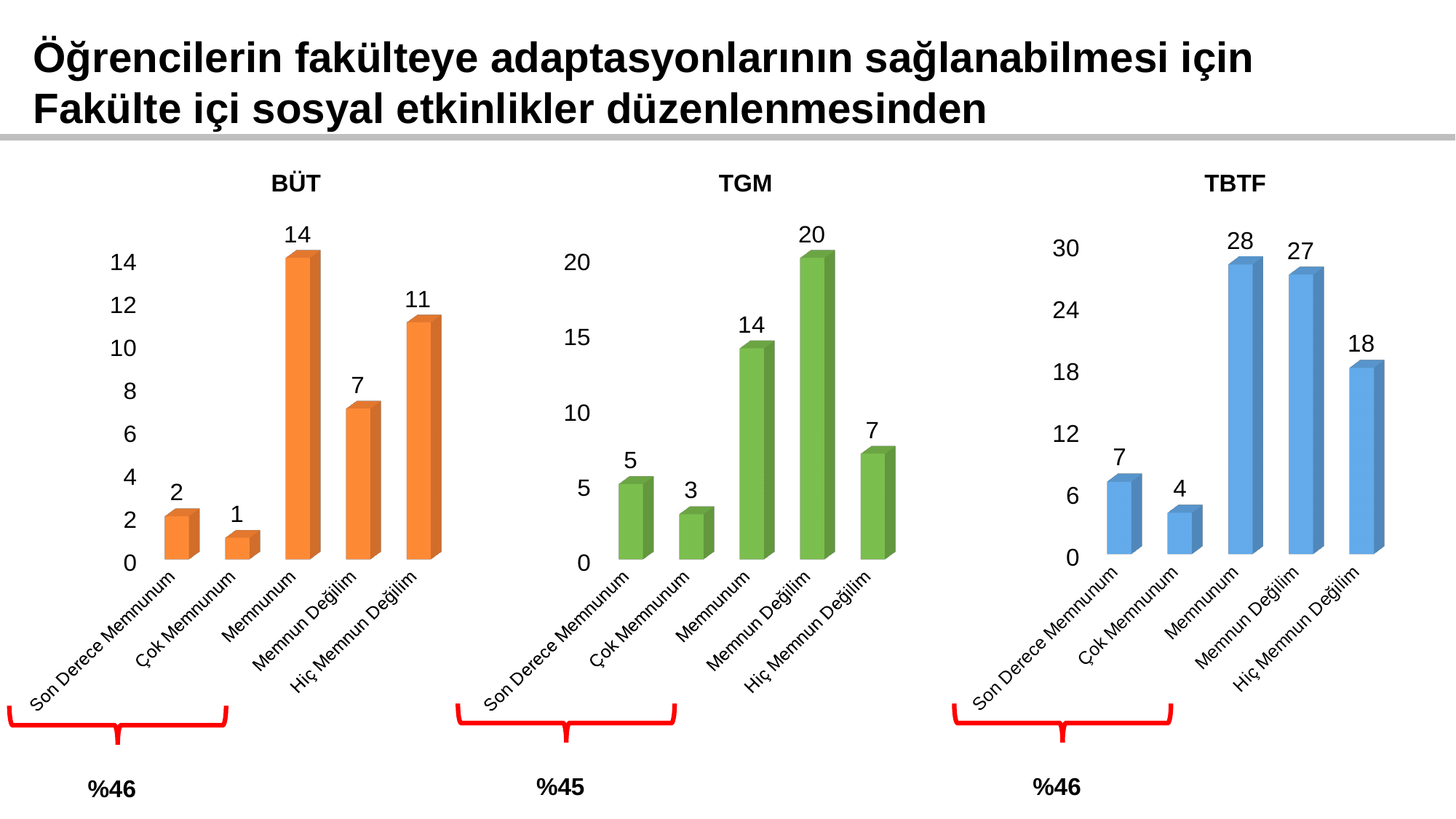
What colour are the bars in the TGM chart? green In the TBTF chart, what is the total of Son Derece Memnunum and Çok Memnunum? 11 In the TBTF chart, is the value for Memnun Değilim greater or less than 24? greater What kind of chart is the BÜT chart? bar chart In the BÜT chart, which is larger: Memnun Değilim or Hiç Memnun Değilim? Hiç Memnun Değilim In the TBTF chart, what is the value for Hiç Memnun Değilim? 18 In the TBTF chart, which category has the highest value? Memnunum In the BÜT chart, which category has the lowest value? Çok Memnunum How many categories does the TGM chart show? 5 In the BÜT chart, what is the value for Memnunum? 14 In the TGM chart, what is the difference between Memnun Değilim and Memnunum? 6 In the TGM chart, what is the value for Memnun Değilim? 20